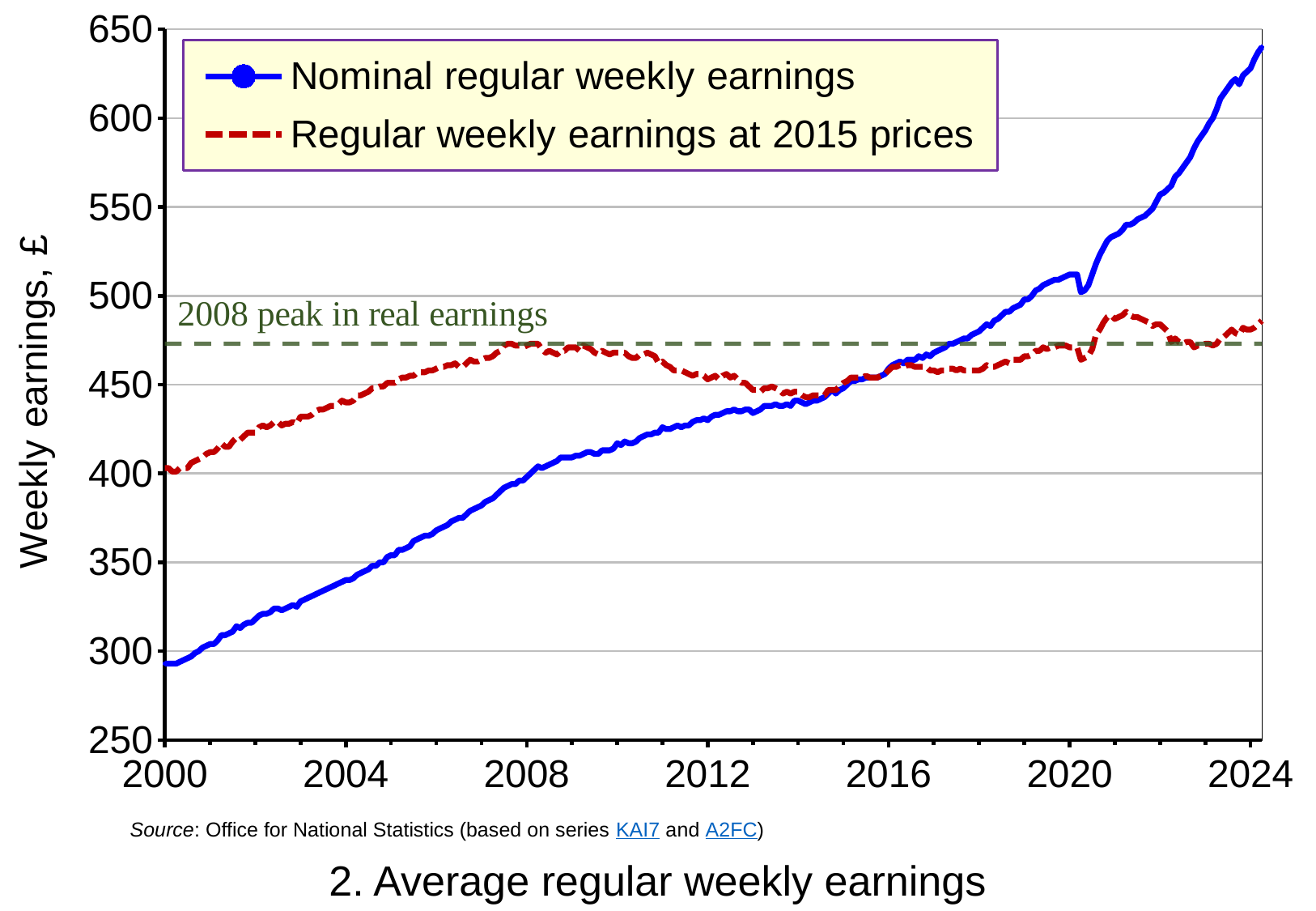
Is the value for Regular weekly earnings at 2015 prices in 2024 greater or less than 500? less What kind of chart is shown on the slide? line chart What is the label on the y axis? Weekly earnings, £ How many series does the legend list? 2 In 2024, which series has the higher value: Nominal regular weekly earnings or Regular weekly earnings at 2015 prices? Nominal regular weekly earnings Is the value for Regular weekly earnings at 2015 prices in 2000 greater or less than 450? less What is the title of the chart? 2. Average regular weekly earnings Do the values for Nominal regular weekly earnings generally rise or fall from 2000 to 2024? rise Is the value for Nominal regular weekly earnings in 2024 greater or less than 600? greater In 2004, which series has the higher value: Nominal regular weekly earnings or Regular weekly earnings at 2015 prices? Regular weekly earnings at 2015 prices